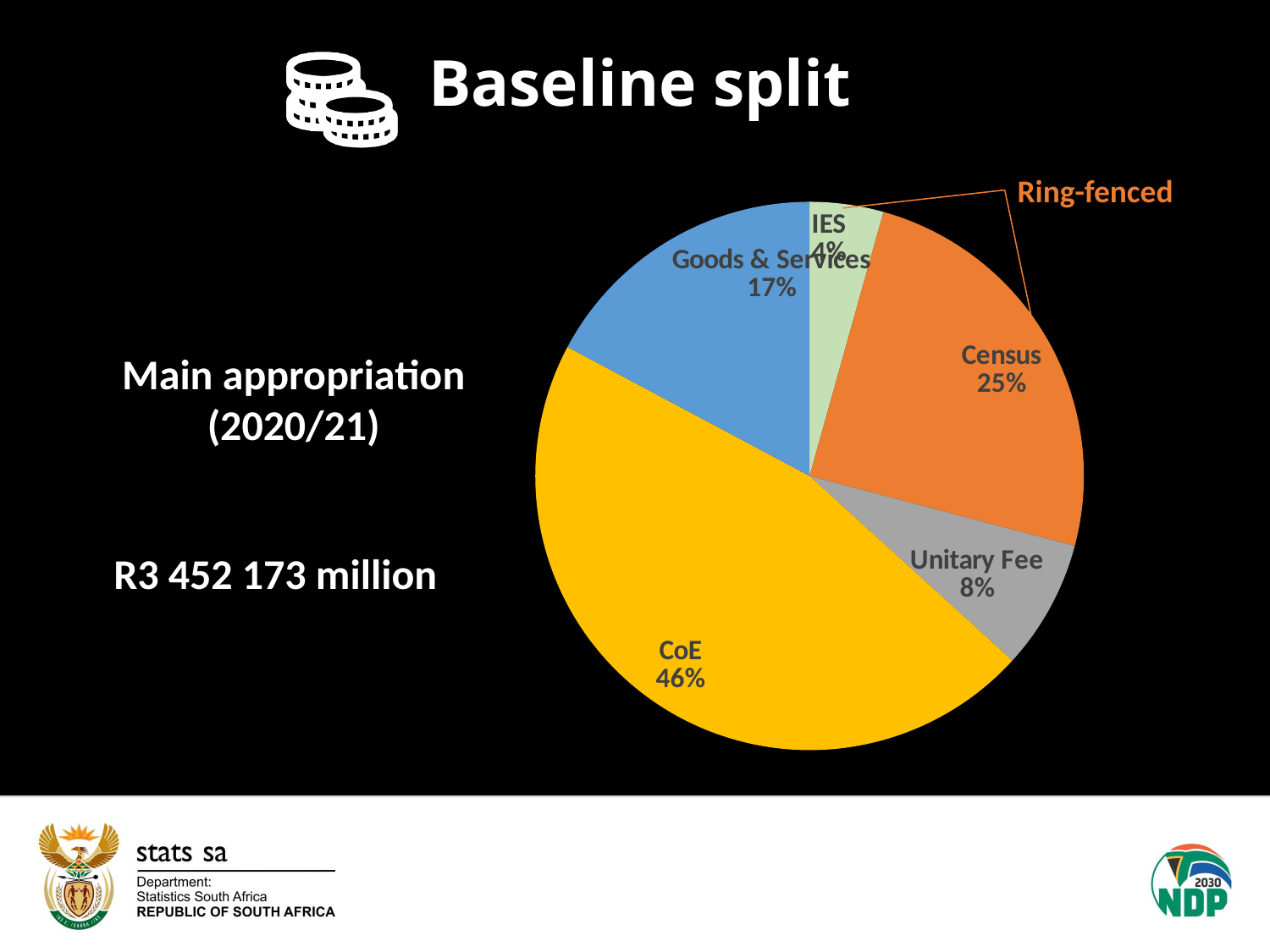
What kind of chart is shown on the slide? Pie chart What share of the pie does CoE represent? 46% Which slices are marked as ring-fenced on the slide? IES and Census Which slice of the pie is the largest? CoE How many slices does the pie chart have? 5 What share of the pie does IES represent? 4% Which slice of the pie is the smallest? IES Which is larger, the Goods & Services slice or the Unitary Fee slice? Goods & Services What share of the pie does Unitary Fee represent? 8% What share of the pie does Goods & Services represent? 17% What is the difference in percentage points between the CoE and Census slices? 21 What share of the pie does Census represent? 25%